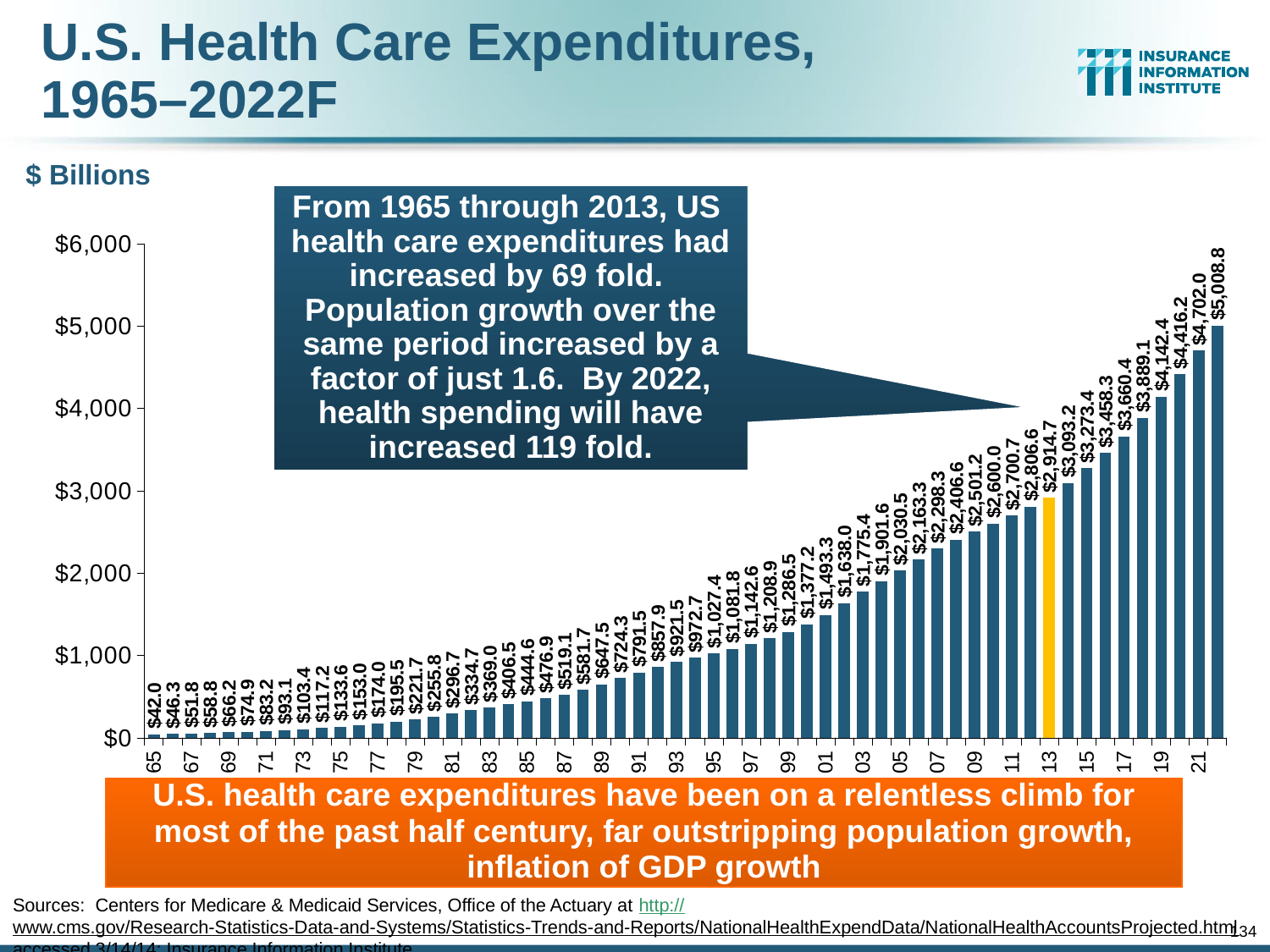
What is the difference between the 2022 value and the 2013 value? $2,094.1 Which year has the highest health care expenditure value on the chart? 2022 (22) Is the value for 2010 (10) greater or less than $2,000? greater How many bars (years) are plotted on the chart? 58 Which is larger, the value for 2000 (00) or the value for 1999 (99)? 2000 (00) Do the values rise or fall as the years progress along the x axis? Rise Which year has the lowest health care expenditure value on the chart? 1965 (65) What is the value of the highlighted bar for 2013? $2,914.7 What is the value of U.S. health care expenditures for 1965 (the '65' bar)? $42.0 What kind of chart is shown on the slide? Bar chart What is the value shown for the 2022 forecast (the '21'-adjacent last bar, labeled 22)? $5,008.8 Which year's bar is highlighted in yellow/orange rather than blue? 2013 (13)